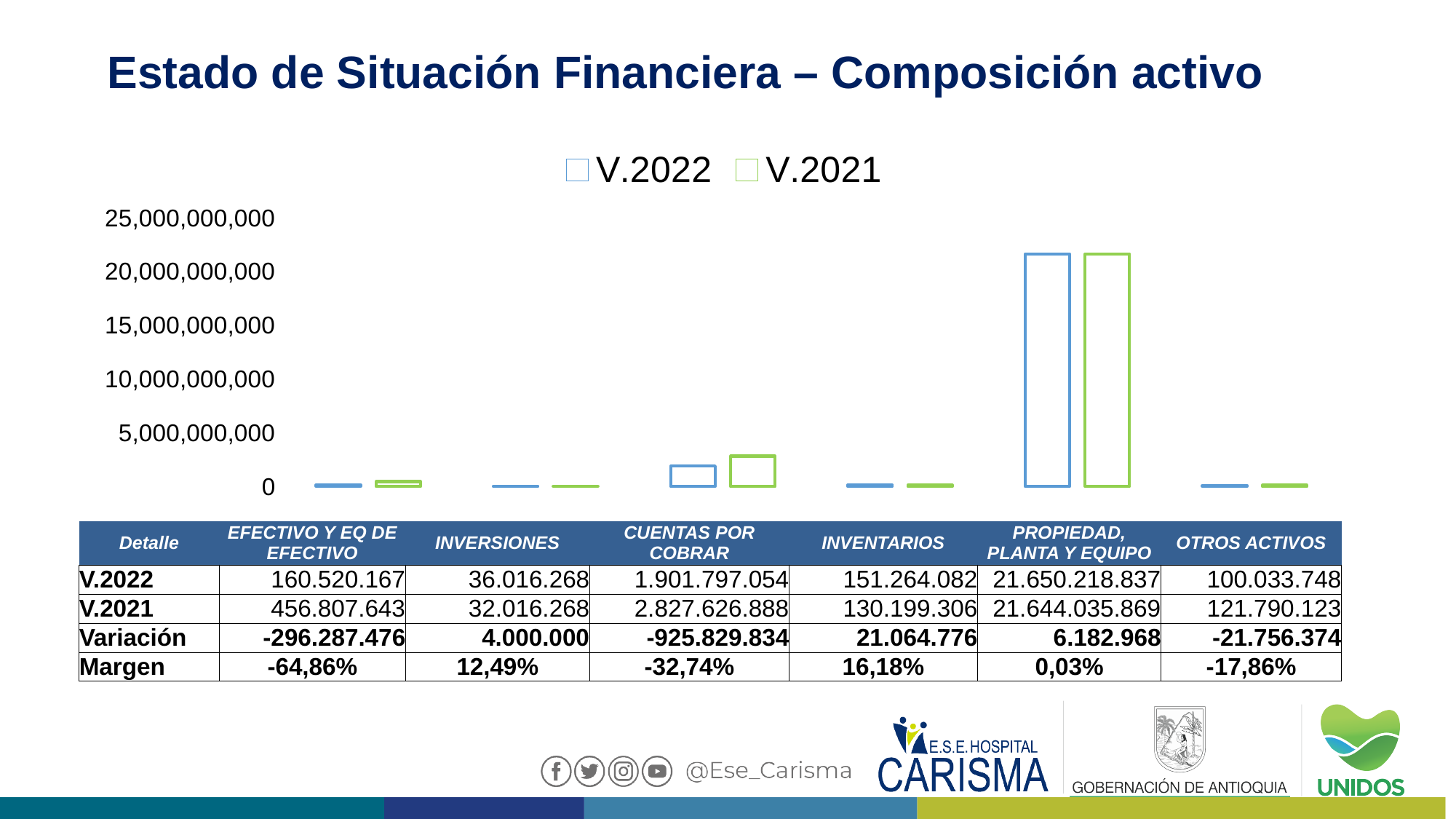
What is the difference between the V.2021 and V.2022 values for CUENTAS POR COBRAR? 925.829.834 What is the V.2022 value for PROPIEDAD, PLANTA Y EQUIPO? 21.650.218.837 Which category has the lowest V.2021 value? INVERSIONES How many categories are plotted along the x axis of the chart? 6 What is the V.2021 value for CUENTAS POR COBRAR? 2.827.626.888 What is the V.2022 value for INVERSIONES? 36.016.268 How many series does the chart legend list? 2 Which category has the highest V.2022 value? PROPIEDAD, PLANTA Y EQUIPO Which is larger for EFECTIVO Y EQ DE EFECTIVO, the V.2022 value or the V.2021 value? V.2021 Is the V.2021 value for PROPIEDAD, PLANTA Y EQUIPO greater or less than 20,000,000,000? greater Which series is drawn in green in the chart? V.2021 What kind of chart is shown on the slide? bar chart